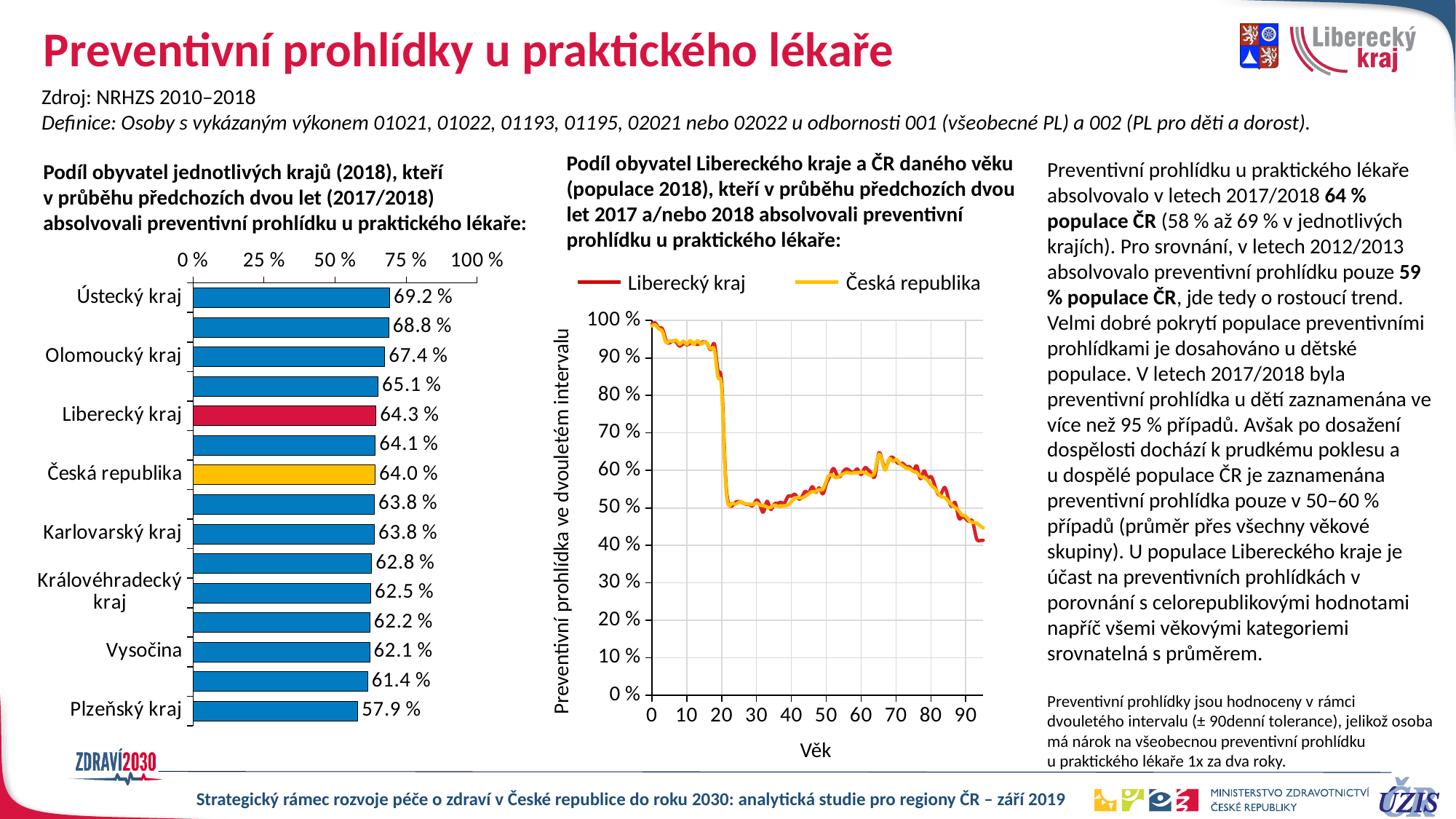
In the bar chart on the left, what is the value for Česká republika? 64.0 % How many series does the legend of the line chart on the right list? 2 In the bar chart on the left, what is the value for Liberecký kraj? 64.3 % How many bars are plotted in the bar chart on the left? 15 In the line chart on the right, is the value for Liberecký kraj at age 10 greater or less than 90 %? greater In the line chart on the right, do the values rise or fall between age 70 and age 90? fall In the bar chart on the left, what is the difference between the values for Ústecký kraj and Plzeňský kraj? 11.3 % In the bar chart on the left, which region has the lowest value? Plzeňský kraj In the bar chart on the left, which region's bar is coloured red? Liberecký kraj In the bar chart on the left, which has a larger value: Olomoucký kraj or Karlovarský kraj? Olomoucký kraj In the bar chart on the left, which region has the highest value? Ústecký kraj What kind of chart is the chart on the left? bar chart